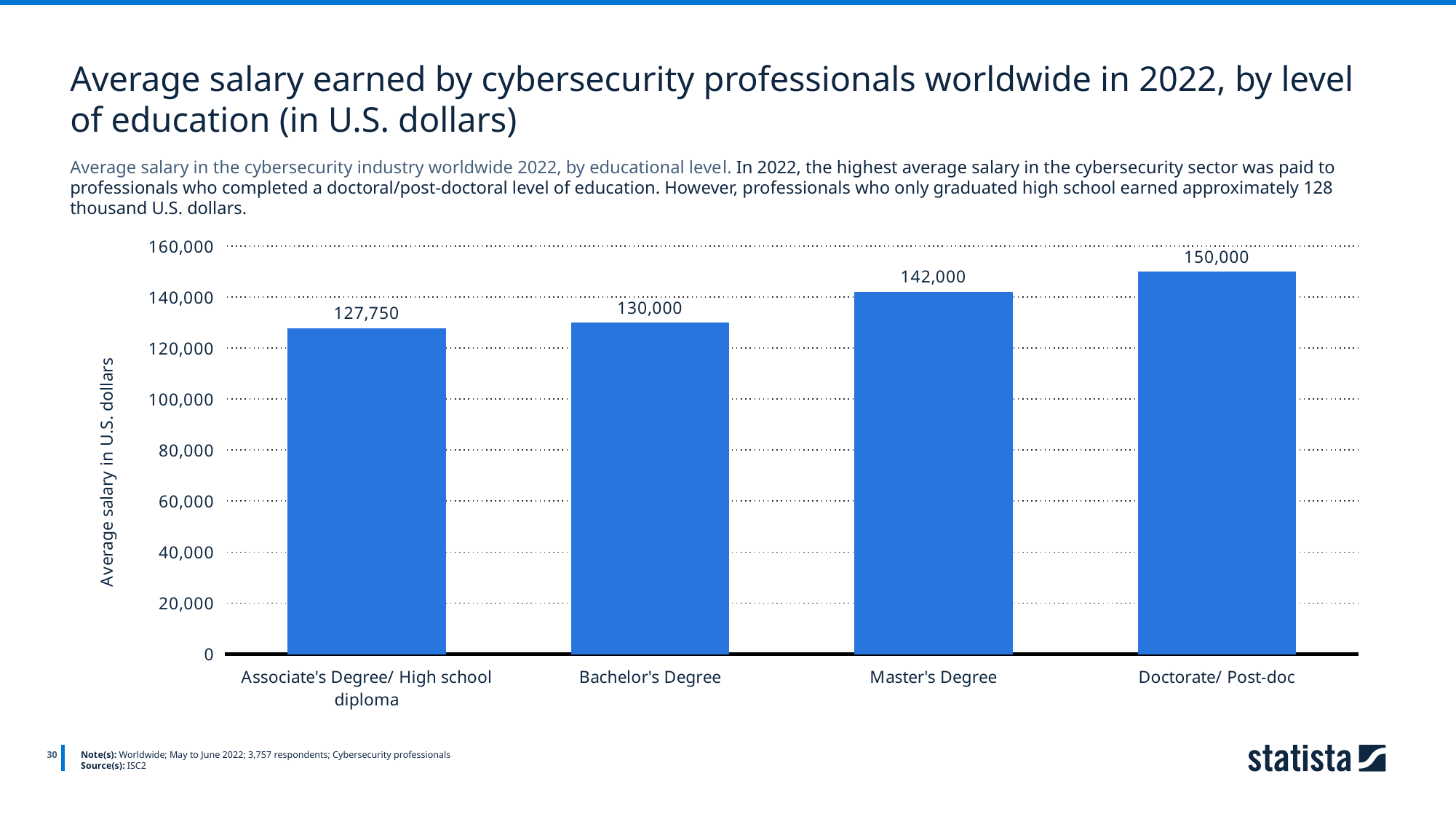
Which is larger, the average salary for Master's Degree or Bachelor's Degree? Master's Degree How many education levels are shown in the chart? 4 What is the difference between the average salary for Doctorate/ Post-doc and Master's Degree? 8,000 What kind of chart is shown on the slide? Bar chart What is the average salary for professionals with a Bachelor's Degree? 130,000 What is the difference between the average salary for Bachelor's Degree and Associate's Degree/ High school diploma? 2,250 What is the average salary for professionals with an Associate's Degree/ High school diploma? 127,750 Which level of education has the highest average salary? Doctorate/ Post-doc What is the average salary for professionals with a Master's Degree? 142,000 Do the values rise or fall from left to right along the x axis? Rise Which level of education has the lowest average salary? Associate's Degree/ High school diploma Is the value for Doctorate/ Post-doc greater or less than 140,000? greater